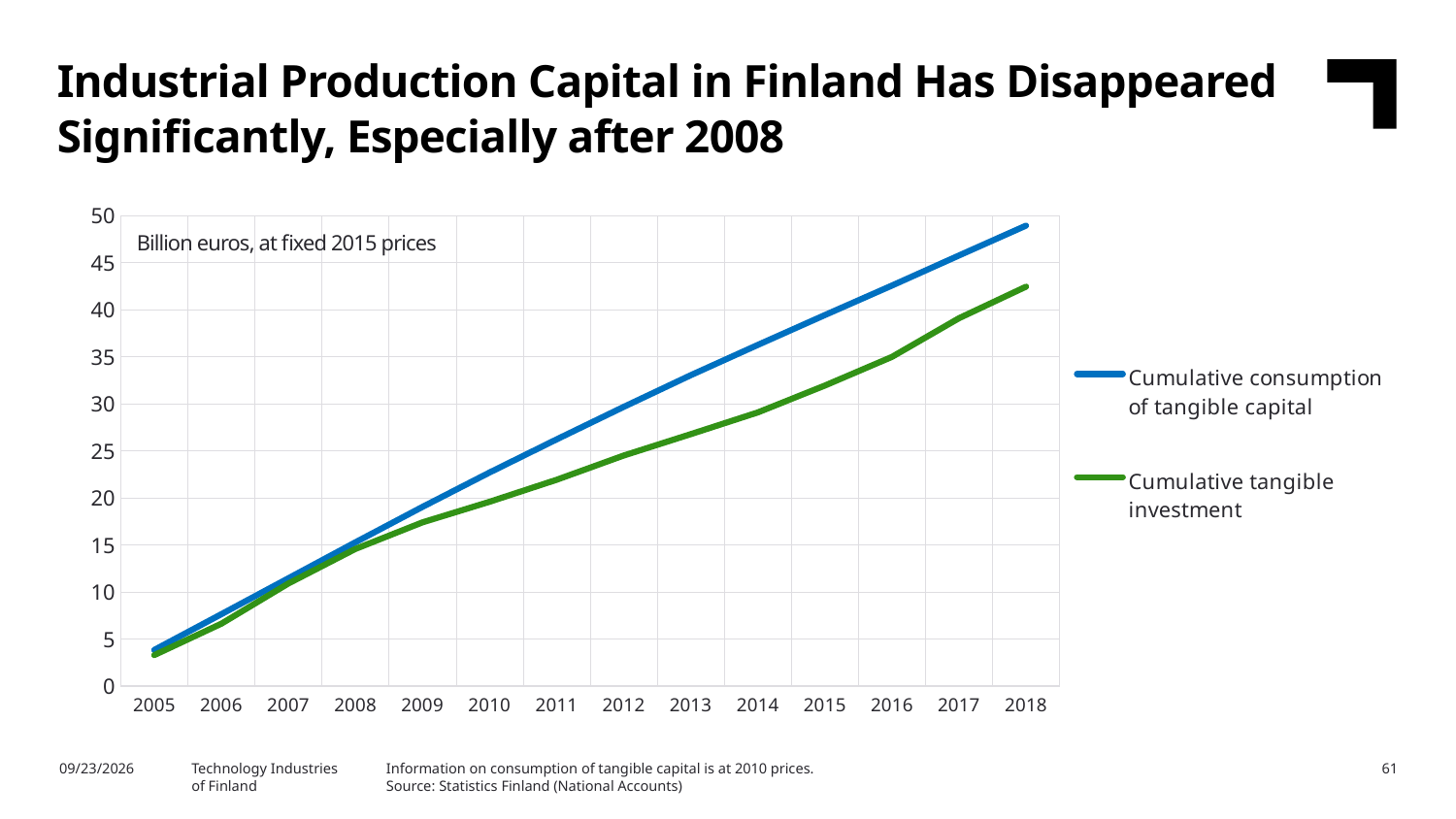
Is the value for Cumulative tangible investment in 2018 greater or less than 45? less Is the value for Cumulative consumption of tangible capital in 2018 greater or less than 45? greater What unit is stated in the text box inside the chart? Billion euros, at fixed 2015 prices Does the Cumulative tangible investment line rise or fall from 2005 to 2018? rise In which year does Cumulative tangible investment reach its highest value? 2018 How many years are shown on the x axis? 14 Is the value for Cumulative tangible investment in 2005 greater or less than 5? less What kind of chart is shown on the slide? line chart How many series does the legend list? 2 Does the Cumulative consumption of tangible capital line rise or fall from 2005 to 2018? rise In 2018, which series has the higher value: Cumulative consumption of tangible capital or Cumulative tangible investment? Cumulative consumption of tangible capital